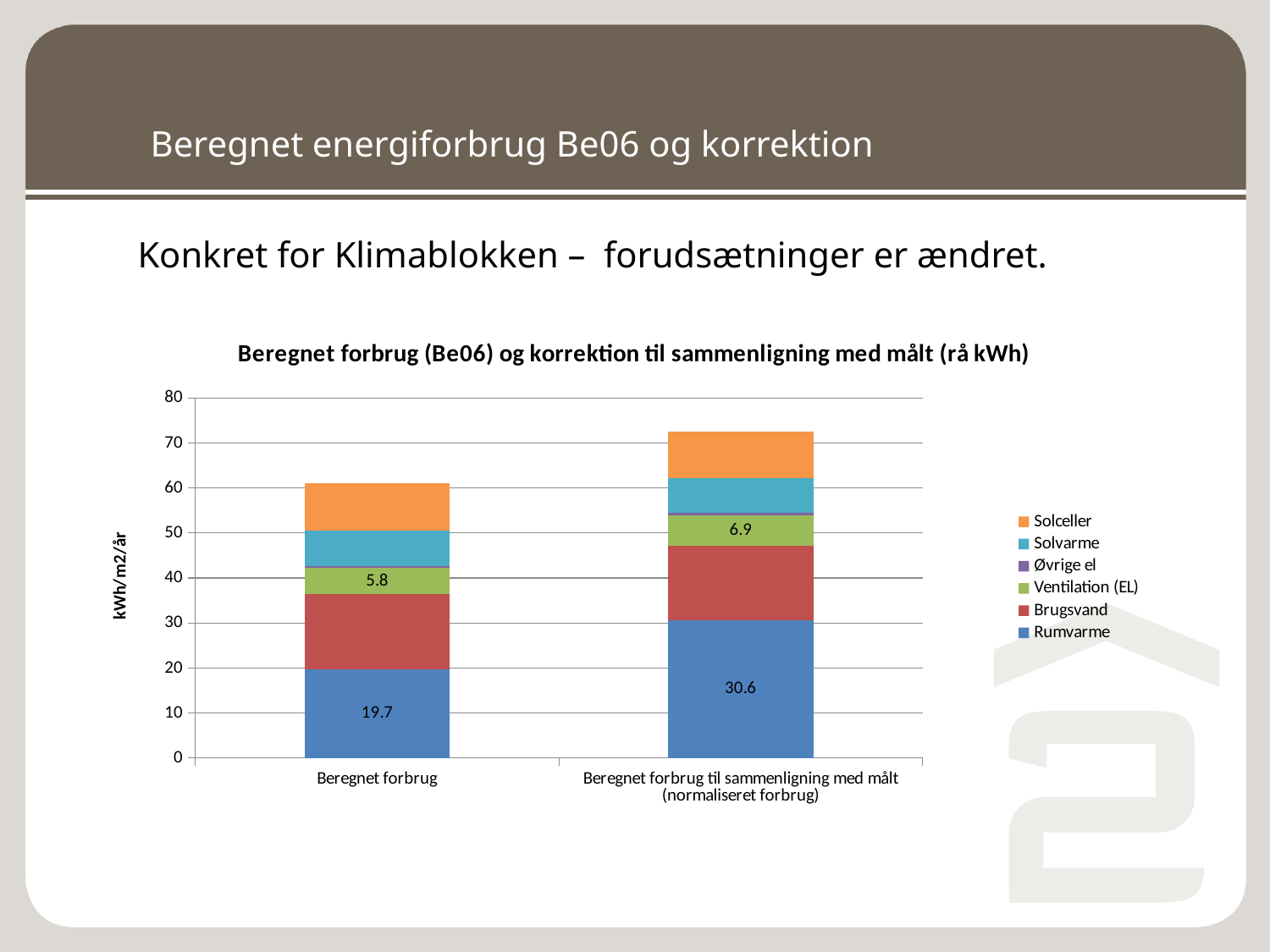
What is the title of the chart? Beregnet forbrug (Be06) og korrektion til sammenligning med målt (rå kWh) What is the difference between the Rumvarme values of the two categories? 10.9 What is the label of the y axis? kWh/m2/år How many categories are shown on the x axis? 2 What is the Rumvarme value for Beregnet forbrug til sammenligning med målt (normaliseret forbrug)? 30.6 What kind of chart is shown on the slide? Stacked bar chart Is the total height of the Beregnet forbrug stacked bar greater or less than 70? less What is the Ventilation (EL) value for Beregnet forbrug til sammenligning med målt (normaliseret forbrug)? 6.9 What is the Ventilation (EL) value for Beregnet forbrug? 5.8 How many series does the legend list? 6 Which category has the larger Rumvarme value? Beregnet forbrug til sammenligning med målt (normaliseret forbrug) What is the Rumvarme value for Beregnet forbrug? 19.7